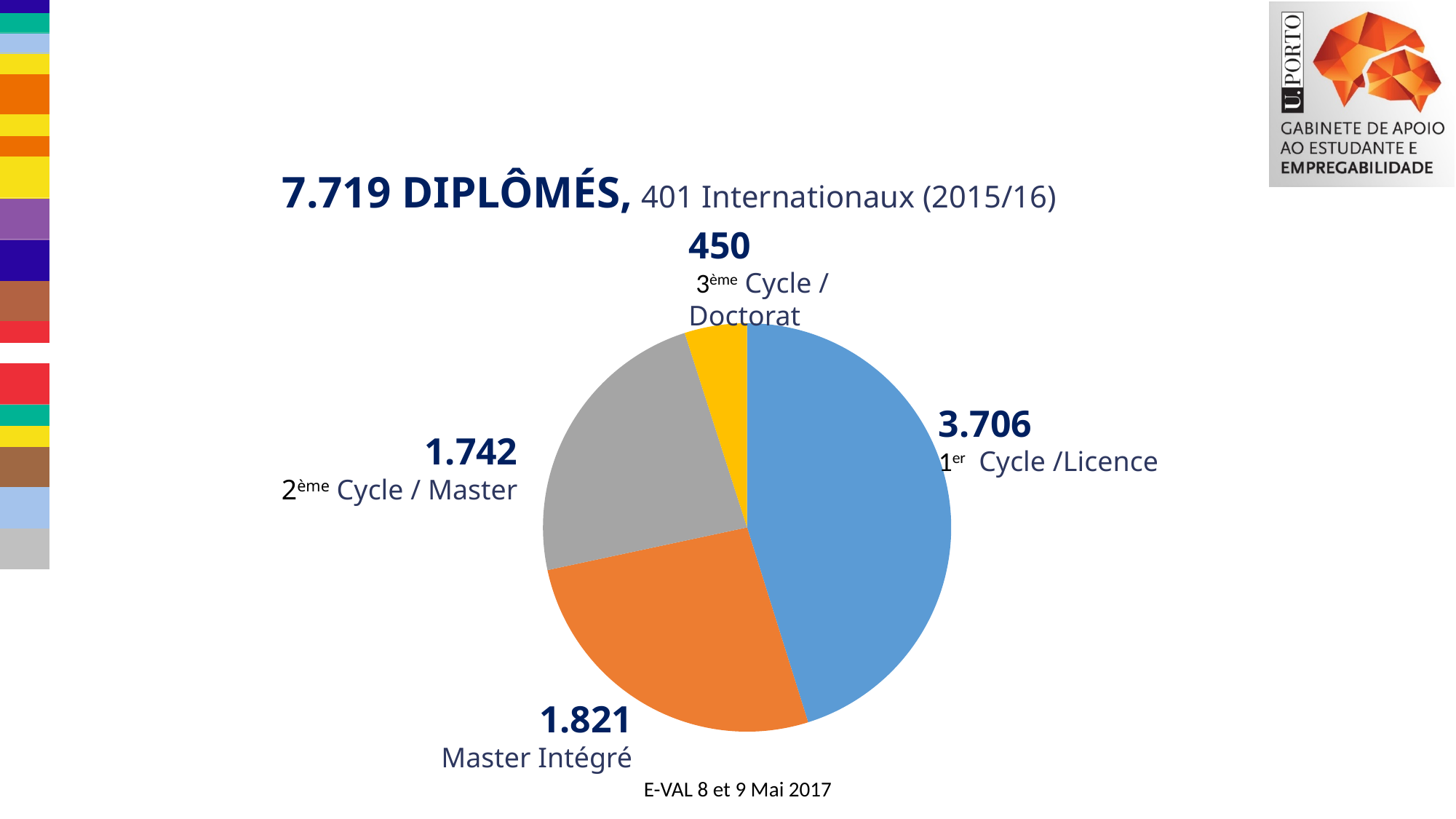
What is the value for 2ème Cycle / Master? 1.742 Which category has the smallest slice of the pie? 3ème Cycle / Doctorat What is the difference between the values for 1er Cycle / Licence and 2ème Cycle / Master? 1.964 What colour is the slice for 3ème Cycle / Doctorat? yellow What type of chart is shown on the slide? pie chart What is the value for 1er Cycle / Licence? 3.706 Which category has the largest slice of the pie? 1er Cycle / Licence What is the total number of graduates (diplômés) stated in the chart title? 7.719 What is the value for 3ème Cycle / Doctorat? 450 Which is larger, the value for Master Intégré or the value for 2ème Cycle / Master? Master Intégré What is the value for Master Intégré? 1.821 How many slices does the pie chart have? 4